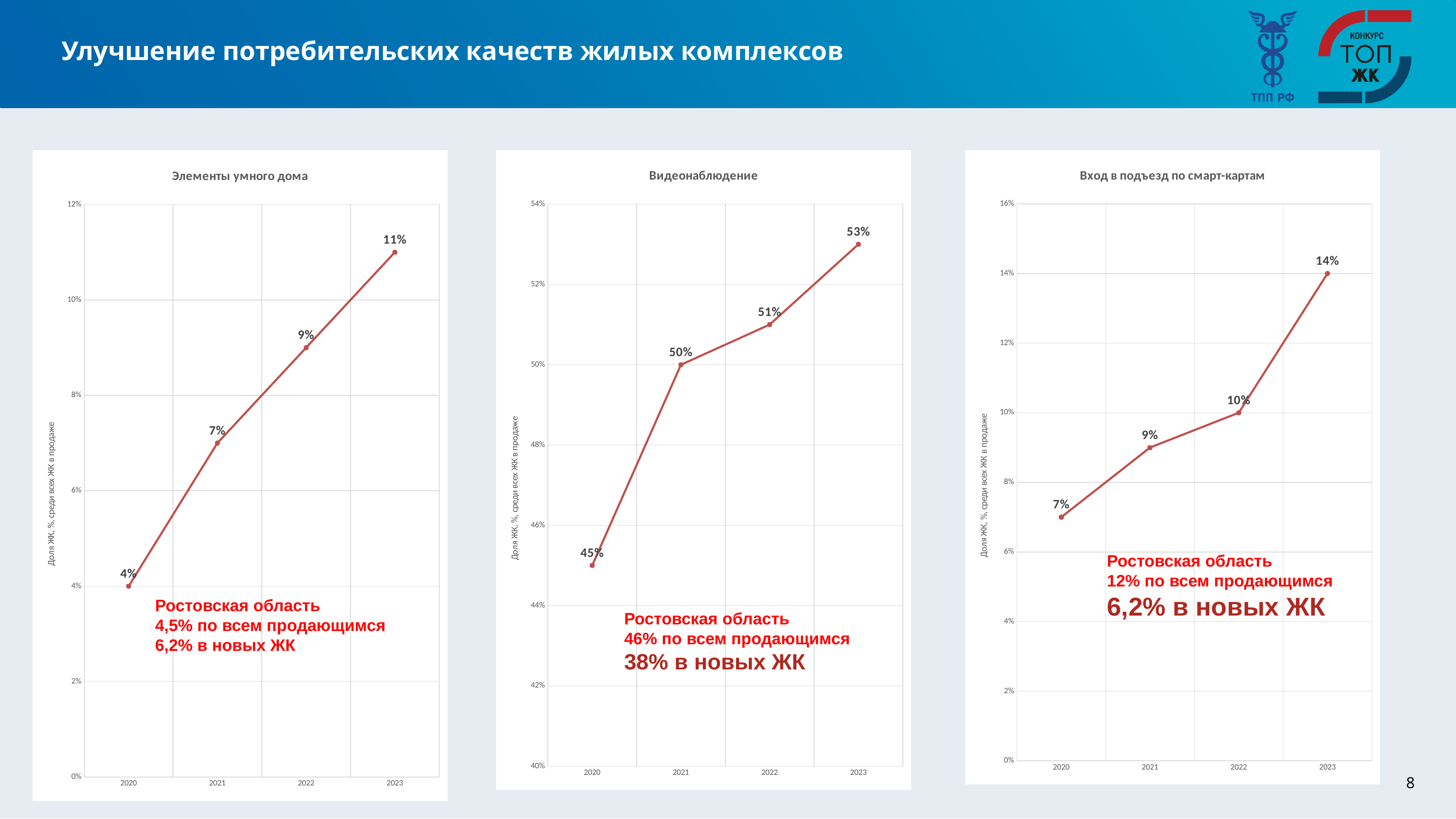
In the chart titled "Видеонаблюдение", which year has the lowest value? 2020 What kind of chart is the chart titled "Элементы умного дома"? line chart In the chart titled "Элементы умного дома", what is the difference between the 2023 and 2020 values? 7% In the chart titled "Видеонаблюдение", what is the difference between the 2022 and 2021 values? 1% In the chart titled "Элементы умного дома", which year has the highest value? 2023 How many charts are shown on the slide? 3 In the chart titled "Вход в подъезд по смарт-картам", what is the value for 2022? 10% In the chart titled "Видеонаблюдение", what is the value for 2020? 45% In the chart titled "Элементы умного дома", what is the value for 2021? 7% In the chart titled "Вход в подъезд по смарт-картам", which is larger, the value for 2021 or the value for 2023? 2023 In the chart titled "Вход в подъезд по смарт-картам", how many years are plotted on the x axis? 4 In the chart titled "Видеонаблюдение", do the values rise or fall from 2020 to 2023? rise